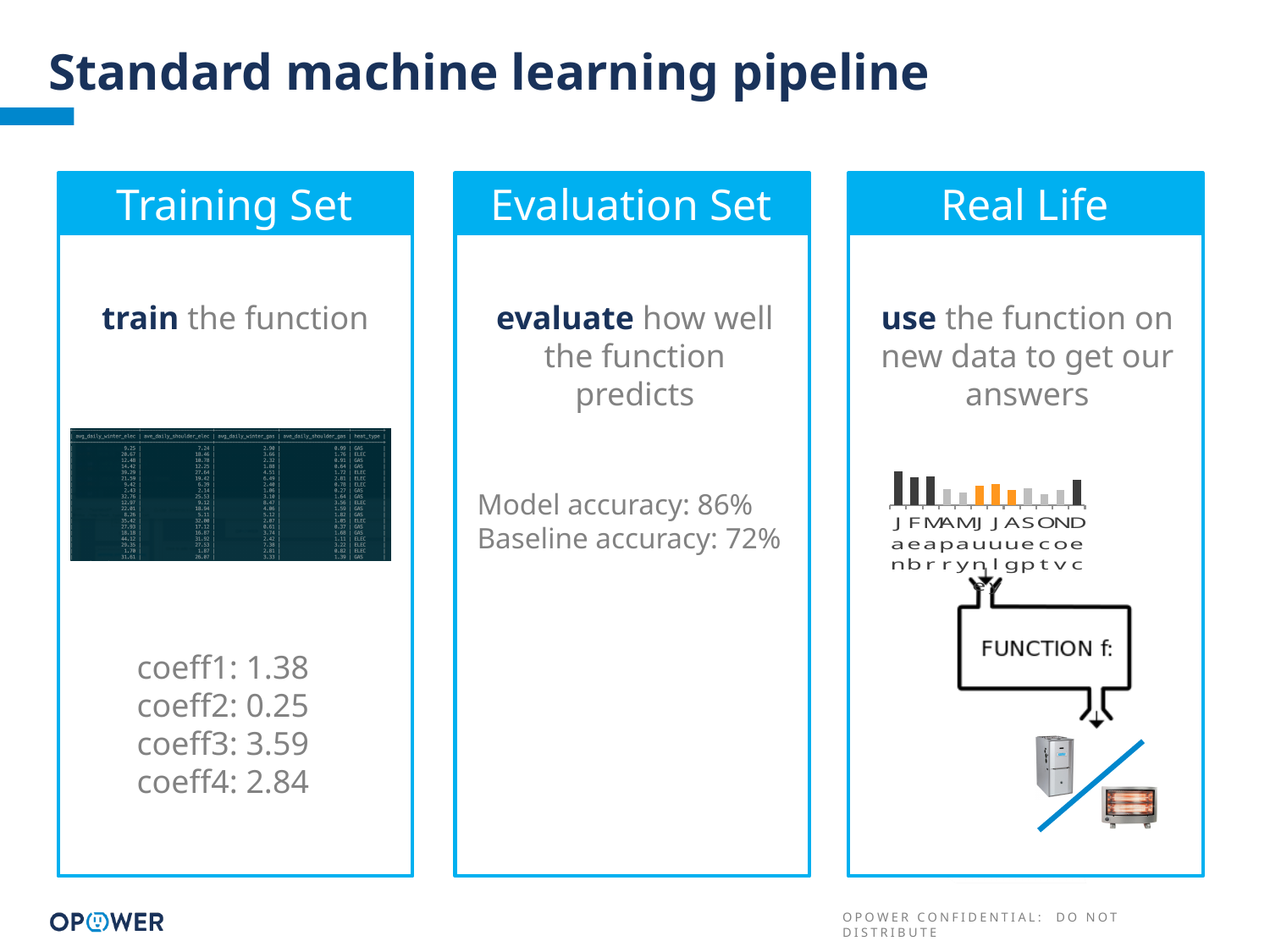
In the Real Life panel's bar chart, how many bars (months) are plotted? 12 In the Real Life panel's bar chart, what do the x-axis labels represent? months of the year (Jan to Dec) In the Real Life panel, what kind of chart is shown above the FUNCTION f box? bar chart In the Real Life panel's bar chart, which is larger, the bar for Dec or the bar for Nov? Dec In the Real Life panel's bar chart, what two colours are used for the bars? dark grey and orange In the Real Life panel's bar chart, which is larger, the bar for Feb or the bar for May? Feb In the Real Life panel's bar chart, which is larger, the bar for Jan or the bar for Apr? Jan